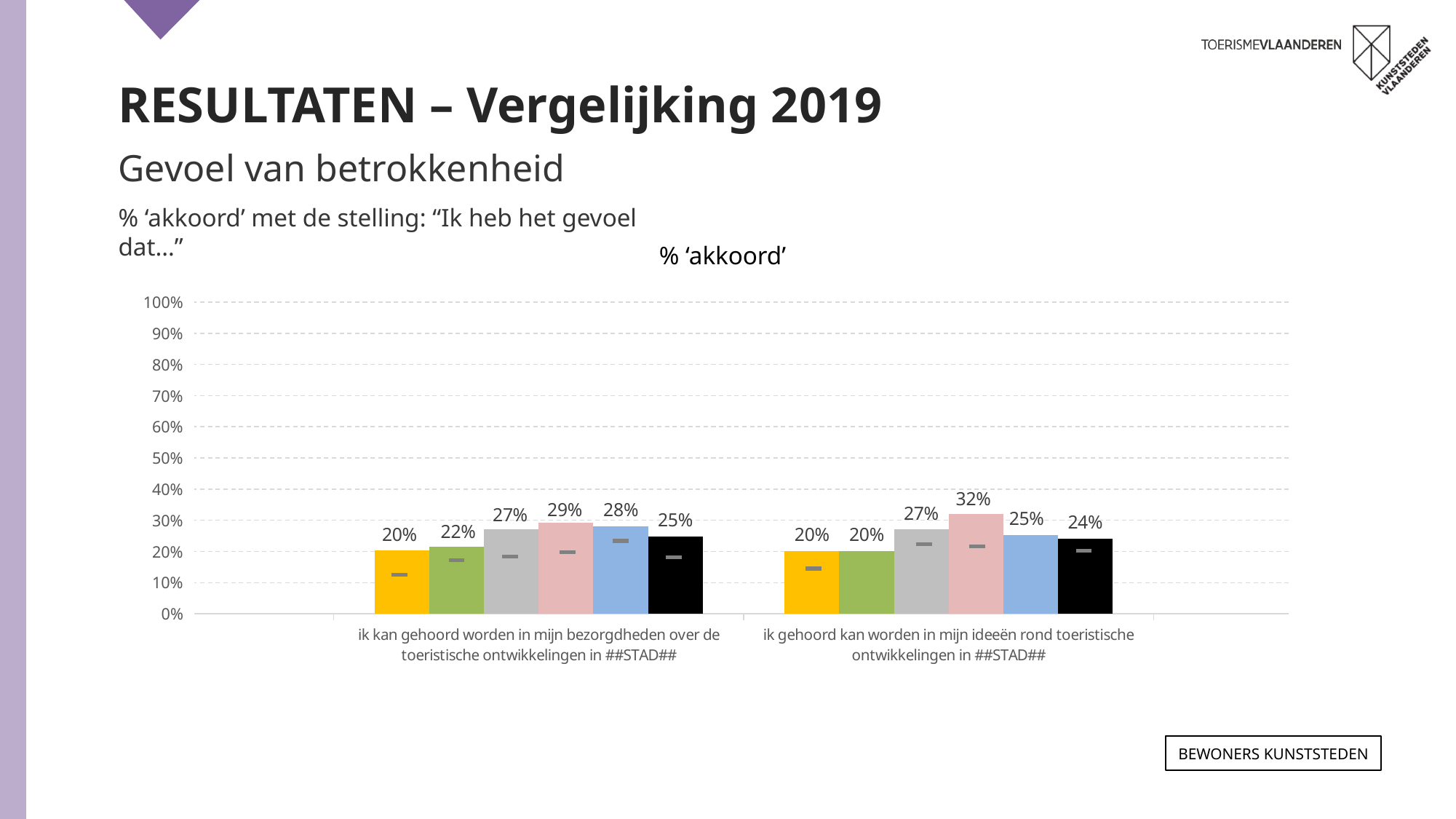
What is the value of the yellow bar for the statement 'ik kan gehoord worden in mijn bezorgdheden over de toeristische ontwikkelingen in ##STAD##'? 20% Which coloured bar has the highest value for the statement 'ik kan gehoord worden in mijn bezorgdheden over de toeristische ontwikkelingen in ##STAD##'? the pink bar (29%) What kind of chart is shown on the slide? bar chart What is the value of the pink bar for the statement 'ik gehoord kan worden in mijn ideeën rond toeristische ontwikkelingen in ##STAD##'? 32% Is the value of the black bar for the statement 'ik kan gehoord worden in mijn bezorgdheden over de toeristische ontwikkelingen in ##STAD##' greater or less than 30%? less Is the blue bar larger for the first statement (bezorgdheden) or for the second statement (ideeën)? the first statement (28% vs 25%) What is the title of the chart? % ‘akkoord’ What is the highest value shown in the whole chart? 32% How many categories (statements) are shown on the x axis of the chart? 2 How many bars are plotted for each statement in the chart? 6 What is the difference between the pink bar and the yellow bar for the statement 'ik gehoord kan worden in mijn ideeën rond toeristische ontwikkelingen in ##STAD##'? 12 percentage points What is the value of the black bar for the statement 'ik gehoord kan worden in mijn ideeën rond toeristische ontwikkelingen in ##STAD##'? 24%